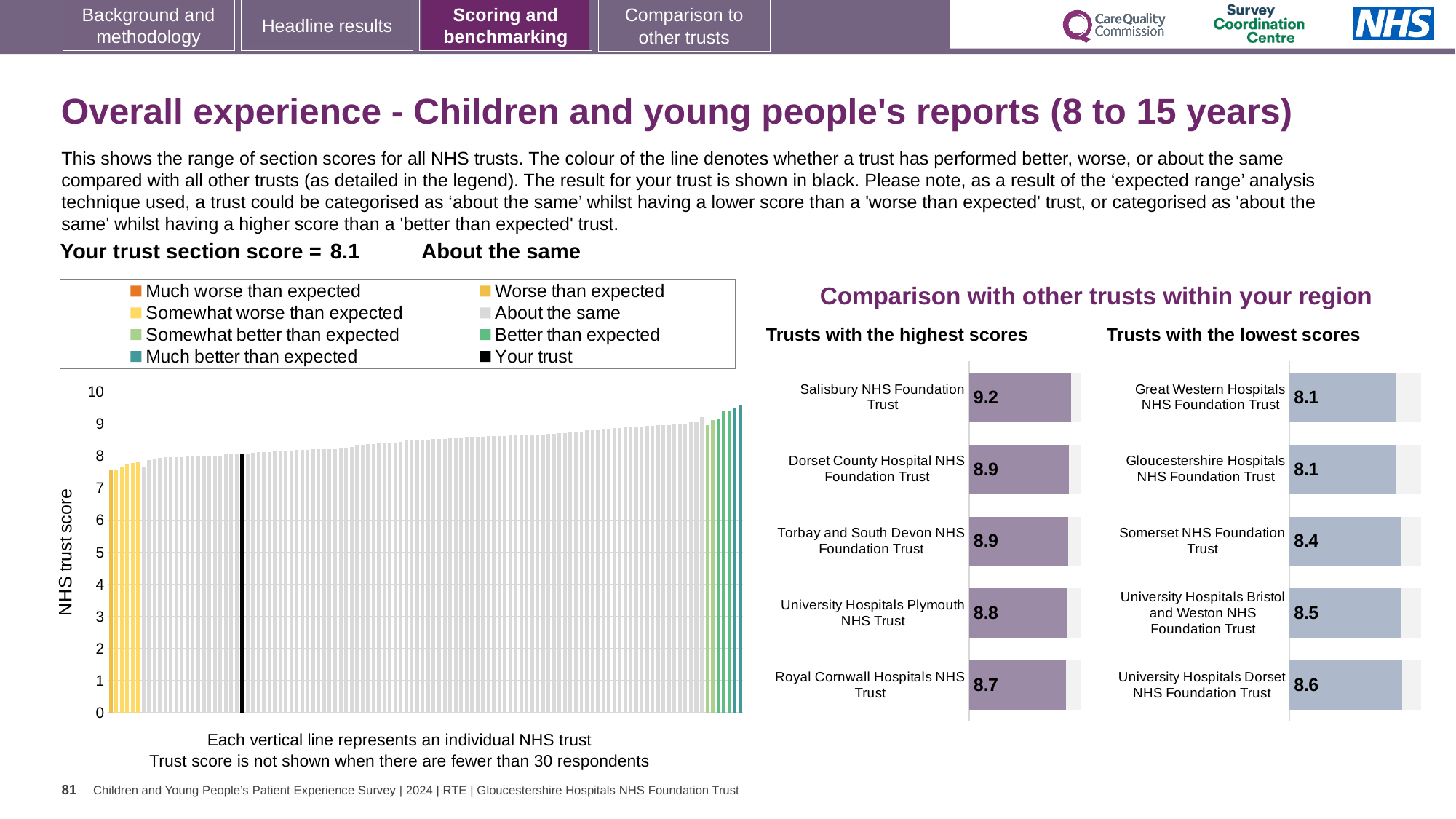
How many entries does the legend above the large chart on the left list? 8 What kind of chart is the large chart on the left showing NHS trust scores? Bar chart In the 'Trusts with the highest scores' chart, how many trusts are listed? 5 What is the y-axis label of the large chart on the left? NHS trust score In the 'Trusts with the lowest scores' chart, which trust has the highest score? University Hospitals Dorset NHS Foundation Trust In the 'Trusts with the highest scores' chart, what is the score for Salisbury NHS Foundation Trust? 9.2 In the 'Trusts with the lowest scores' chart, what is the score for Somerset NHS Foundation Trust? 8.4 In the 'Trusts with the highest scores' chart, which trust has the lowest score shown? Royal Cornwall Hospitals NHS Trust In the large chart on the left, do the trust scores rise or fall from left to right? Rise In the 'Trusts with the lowest scores' chart, what is the difference between the scores of University Hospitals Dorset NHS Foundation Trust and Gloucestershire Hospitals NHS Foundation Trust? 0.5 In the 'Trusts with the lowest scores' chart, which has the larger score: Somerset NHS Foundation Trust or University Hospitals Bristol and Weston NHS Foundation Trust? University Hospitals Bristol and Weston NHS Foundation Trust In the 'Trusts with the highest scores' chart, what is the difference between the scores of Salisbury NHS Foundation Trust and Royal Cornwall Hospitals NHS Trust? 0.5